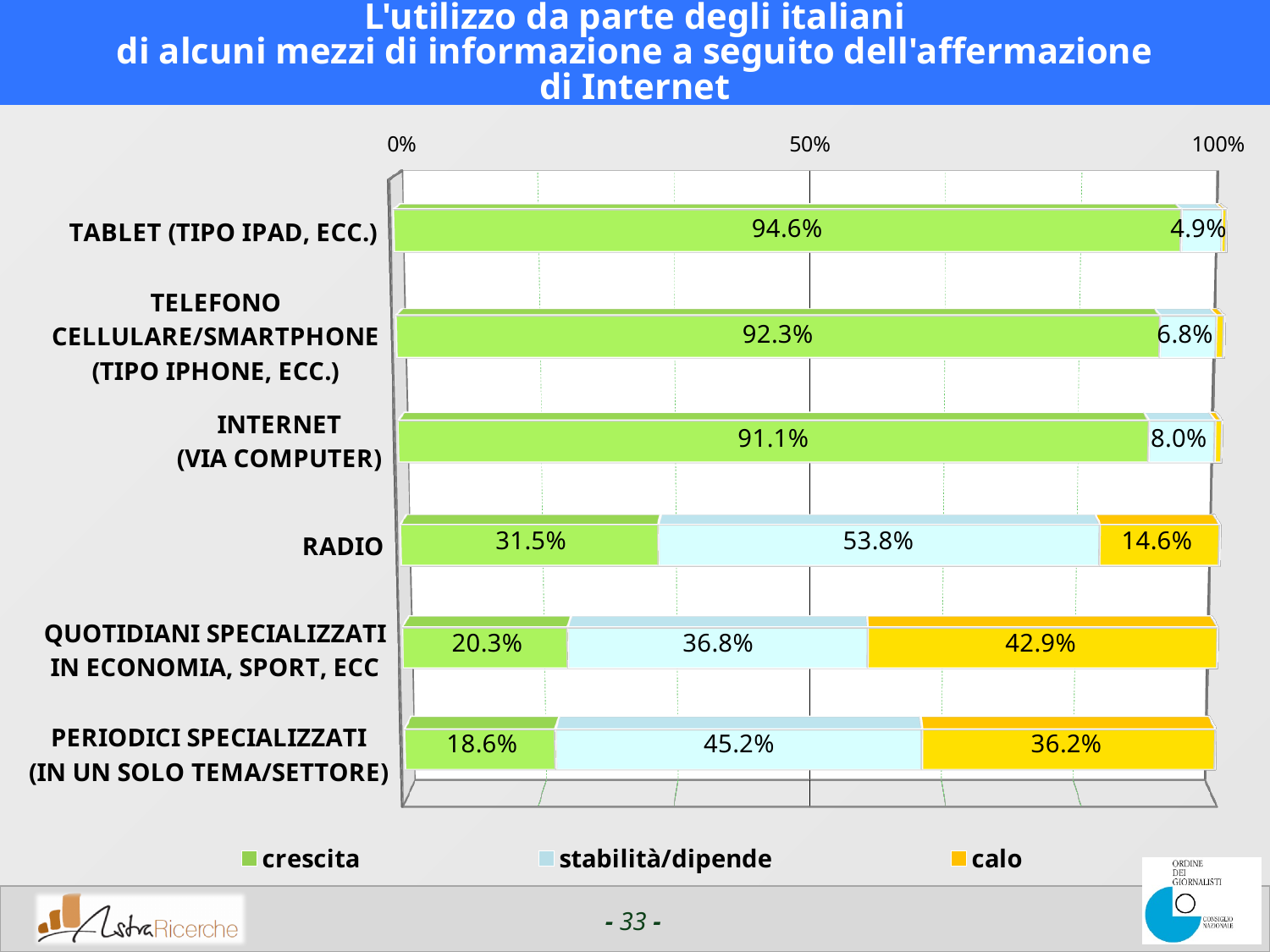
Which category has the lowest 'crescita' value? PERIODICI SPECIALIZZATI (IN UN SOLO TEMA/SETTORE) Is the 'crescita' value for TELEFONO CELLULARE/SMARTPHONE (TIPO IPHONE, ECC.) greater or less than 50%? greater What is the 'calo' value for QUOTIDIANI SPECIALIZZATI IN ECONOMIA, SPORT, ECC? 42.9% What kind of chart is shown on the slide? Stacked bar chart What is the 'crescita' value for TABLET (TIPO IPAD, ECC.)? 94.6% Which is larger: the 'calo' value for QUOTIDIANI SPECIALIZZATI IN ECONOMIA, SPORT, ECC or for PERIODICI SPECIALIZZATI (IN UN SOLO TEMA/SETTORE)? QUOTIDIANI SPECIALIZZATI IN ECONOMIA, SPORT, ECC What is the 'stabilità/dipende' value for RADIO? 53.8% How many categories are shown on the chart? 6 Which category has the highest 'crescita' value? TABLET (TIPO IPAD, ECC.) What is the 'stabilità/dipende' value for INTERNET (VIA COMPUTER)? 8.0% What is the difference between the 'crescita' values for RADIO and PERIODICI SPECIALIZZATI (IN UN SOLO TEMA/SETTORE)? 12.9% How many series does the legend list? 3